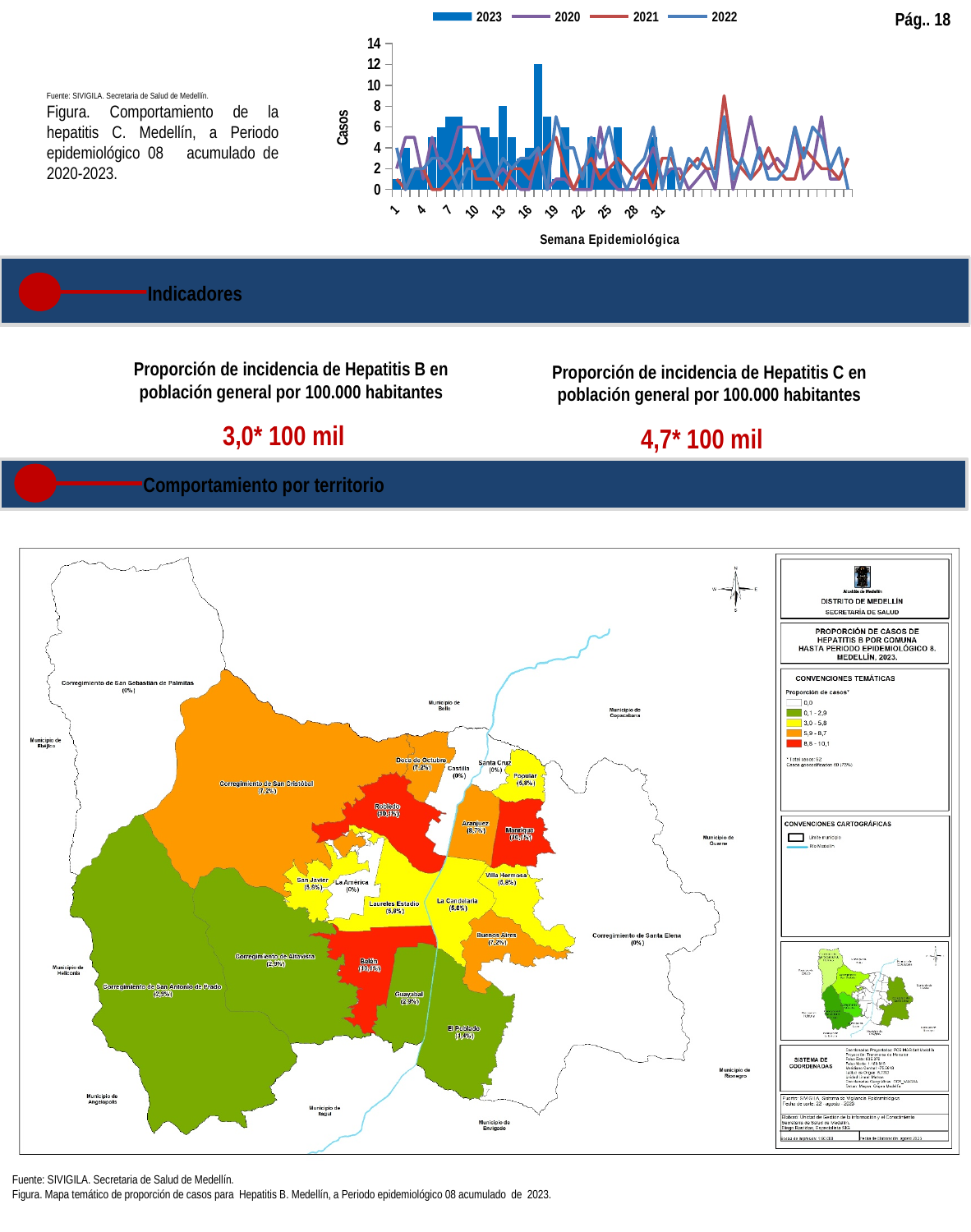
At the week where the 2023 bar is tallest, which is larger: the 2023 bar or the 2021 line? 2023 bar How many series does the legend of the hepatitis C chart list? 4 What kind of chart is used to show hepatitis C cases by epidemiological week? Combined bar and line chart Which series reaches the highest value anywhere on the hepatitis C chart? 2023 What is the title of the vertical axis of the hepatitis C chart? Casos Which year is plotted as bars in the hepatitis C chart? 2023 How many series are drawn as lines in the hepatitis C chart? 3 Is the 2023 bar at week 1 of the hepatitis C chart greater or less than 4? less Is the tallest 2023 bar in the hepatitis C chart greater or less than 10? greater Is the highest point of the 2021 line in the hepatitis C chart greater or less than 6? greater